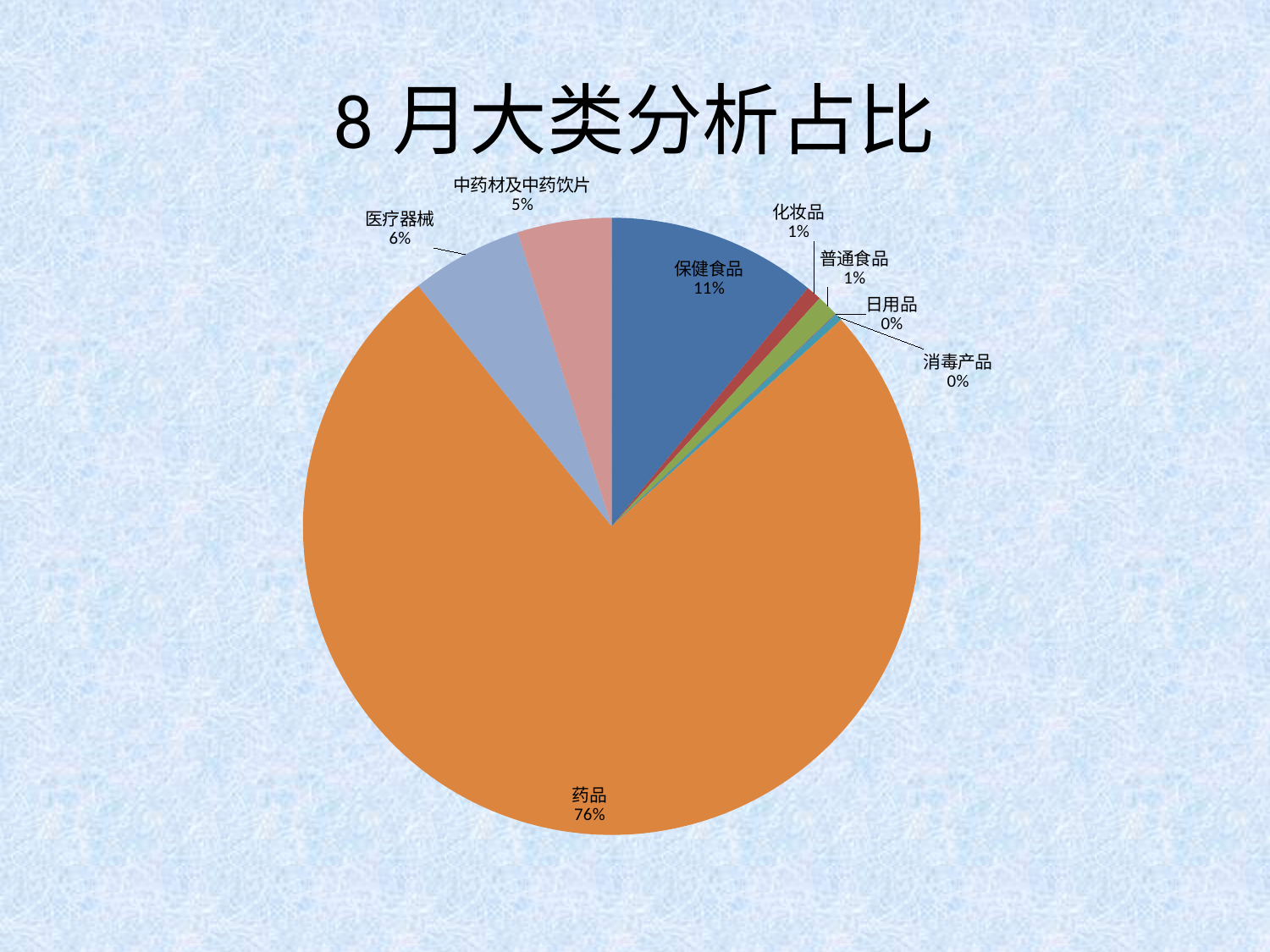
What is the title of the chart? 8 月大类分析占比 What share of the pie does 药品 take? 76% What is the value shown for 保健食品? 11% Which is larger, the share for 医疗器械 or the share for 中药材及中药饮片? 医疗器械 How many categories are shown in the pie chart? 8 What is the value shown for 中药材及中药饮片? 5% What is the value shown for 医疗器械? 6% What is the value shown for 消毒产品? 0% What type of chart is shown on the slide? pie chart What is the difference in percentage points between 药品 and 保健食品? 65% Which category has the largest share of the pie? 药品 What is the value shown for 化妆品? 1%